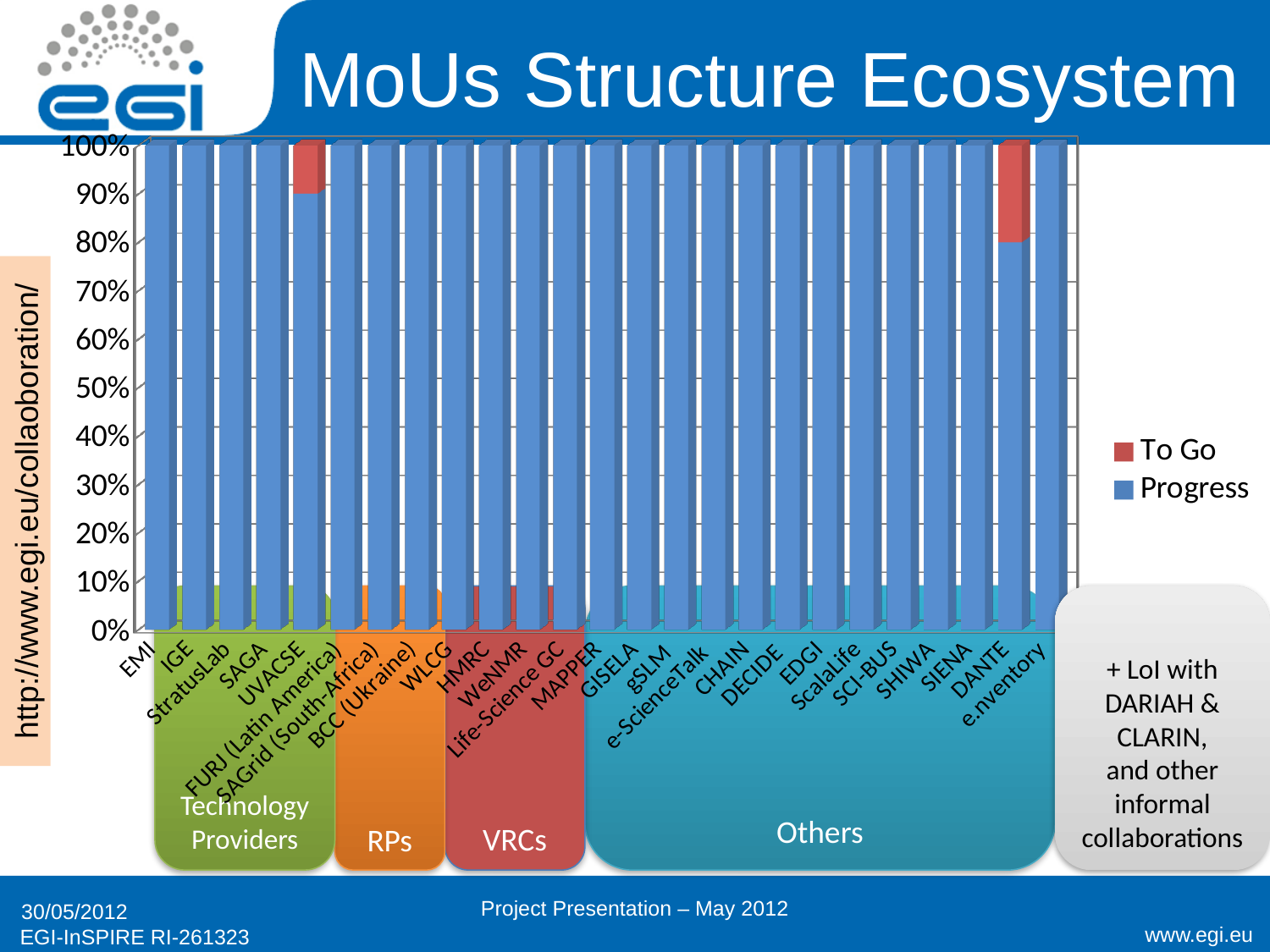
How many series does the chart legend list? 2 What is the total of the stacked bar for WLCG? 100% Which category has the highest To Go value? DANTE What kind of chart is shown on the slide? bar chart Which has the larger To Go value, DANTE or UVACSE? DANTE What is the Progress value for UVACSE? 90% What colour represents the To Go series in the chart? red How many categories (bars) are plotted along the x axis of the chart? 25 Is the Progress value for DANTE greater or less than 90%? less Is the Progress value for UVACSE greater or less than 80%? greater What is the Progress value for EMI? 100% What are the two series named in the chart legend? To Go and Progress